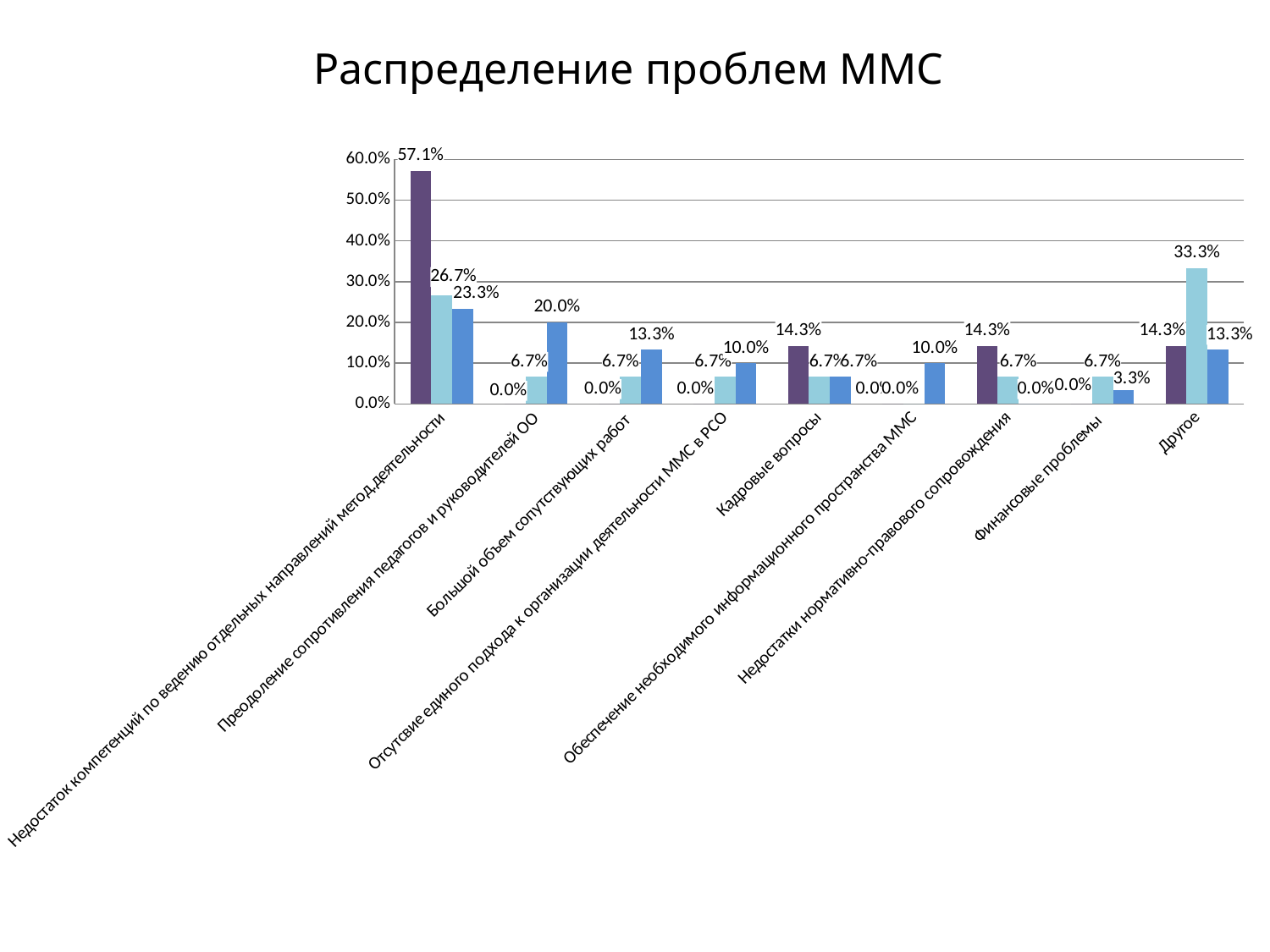
Which is larger for 'Финансовые проблемы': the light blue bar or the medium blue bar? the light blue bar What is the value of the medium blue bar for 'Преодоление сопротивления педагогов и руководителей ОО'? 20.0% How many categories are shown on the x axis of the chart? 9 What is the difference between the dark purple bar and the light blue bar for 'Недостаток компетенций по ведению отдельных направлений метод.деятельности'? 30.4% Which category has the highest light blue bar? Другое What is the title of the chart? Распределение проблем ММС What is the value of the light blue bar for 'Другое'? 33.3% What is the value of the dark purple bar for 'Недостаток компетенций по ведению отдельных направлений метод.деятельности'? 57.1% What is the value of the dark purple bar for 'Кадровые вопросы'? 14.3% What type of chart is shown on the slide? bar chart What is the value of the medium blue bar for 'Обеспечение необходимого информационного пространства ММС'? 10.0% Which category has the highest dark purple bar? Недостаток компетенций по ведению отдельных направлений метод.деятельности